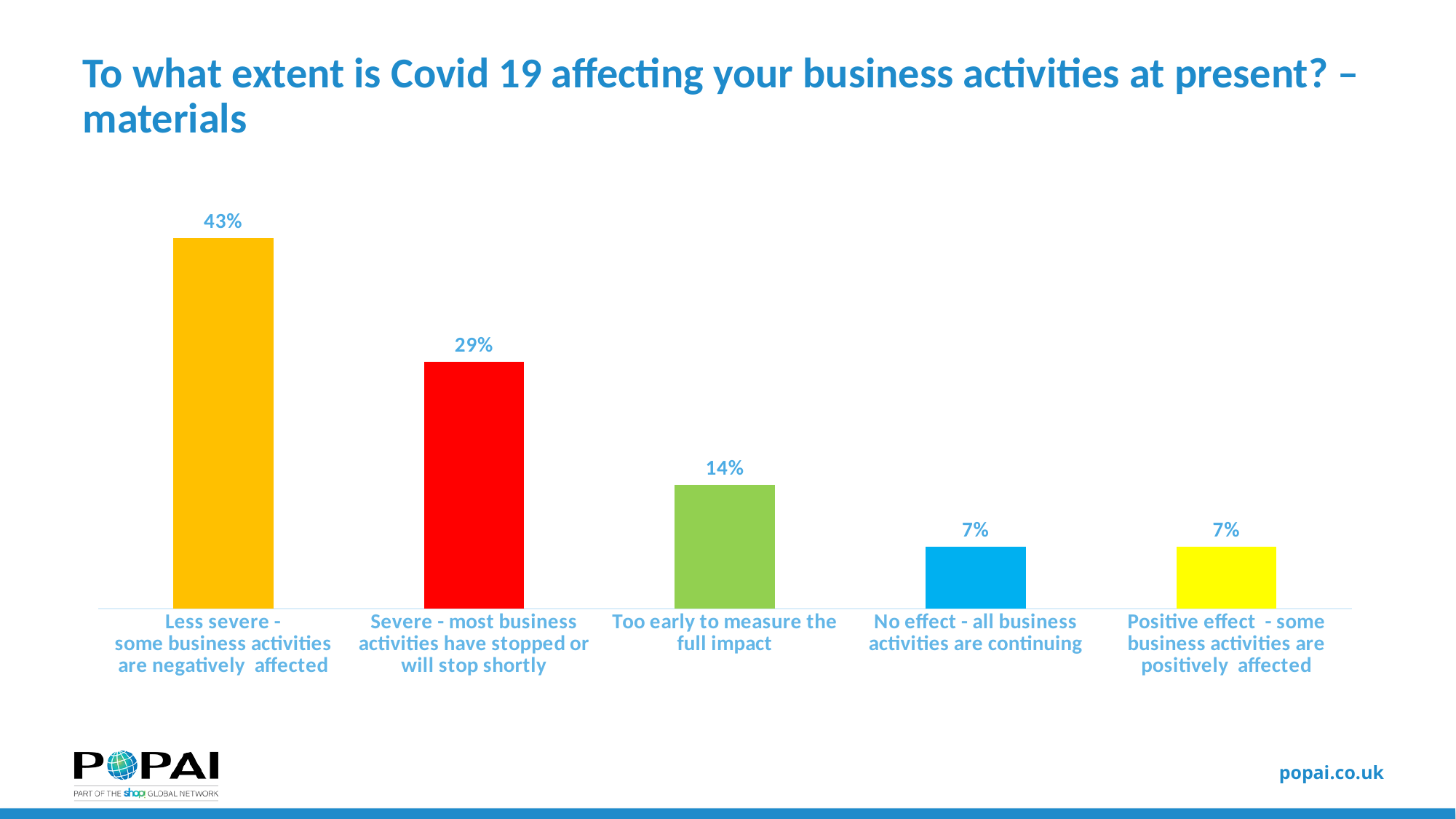
How many response categories are shown in the chart? 5 What is the difference in percentage points between the 'Less severe' and 'Severe' categories? 14 Which is larger: the percentage for 'Severe - most business activities have stopped or will stop shortly' or for 'Too early to measure the full impact'? Severe - most business activities have stopped or will stop shortly What percentage of respondents said it is too early to measure the full impact? 14% What is the difference in percentage points between 'Too early to measure the full impact' and 'No effect - all business activities are continuing'? 7 What percentage of respondents said the effect is severe, with most business activities stopped or stopping shortly? 29% What percentage of respondents said the effect is less severe, with some business activities negatively affected? 43% Which response category has the highest percentage? Less severe - some business activities are negatively affected Do the values generally rise or fall from left to right across the categories? Fall What type of chart is shown on the slide? Bar chart What colour is the bar for 'Severe - most business activities have stopped or will stop shortly'? Red What percentage of respondents reported no effect, with all business activities continuing? 7%